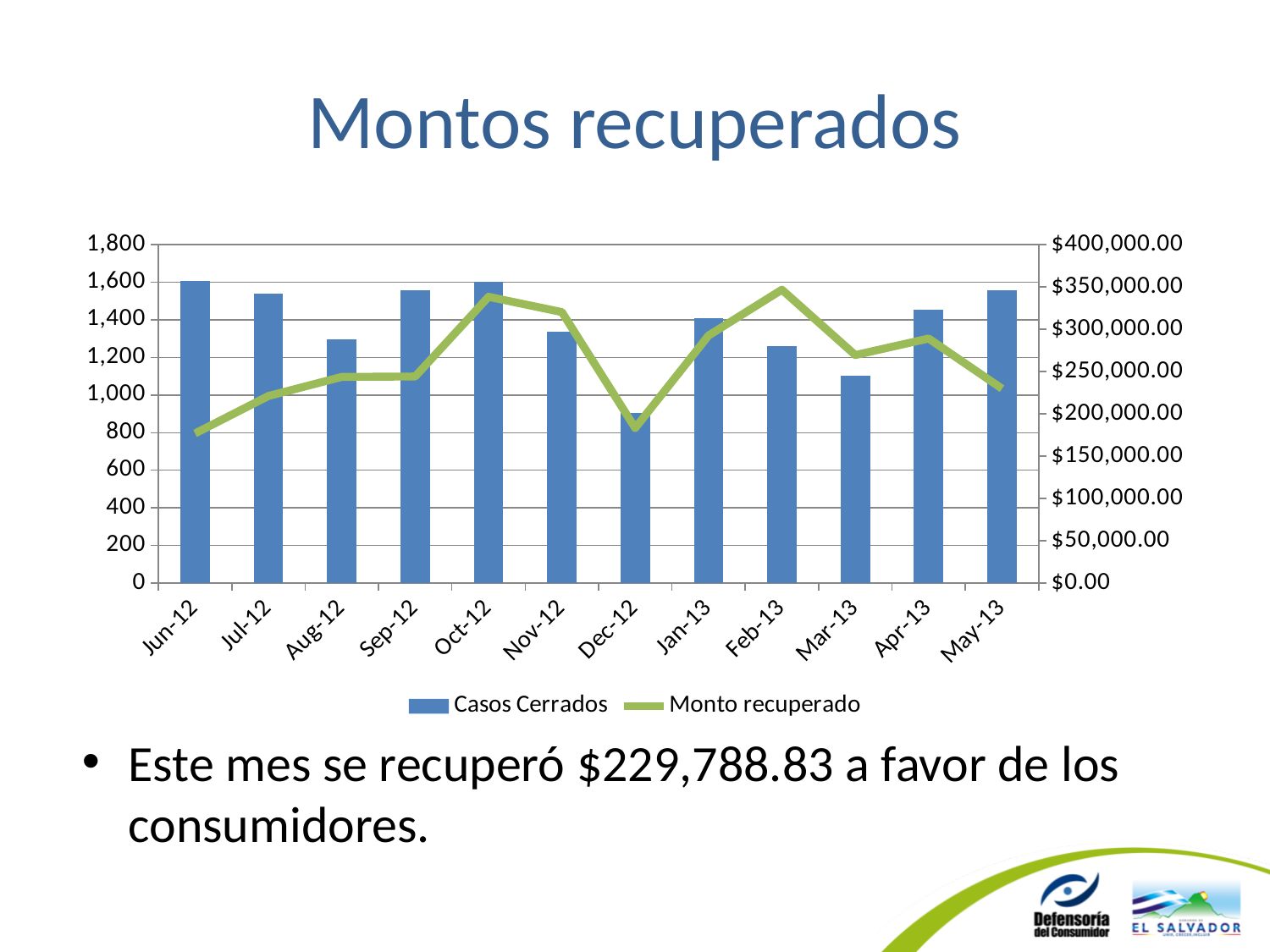
How many months are shown on the x axis of the chart? 12 Is the Monto recuperado value for Jun-12 greater or less than $200,000.00? less Which series is drawn as a line in the chart? Monto recuperado Is the Monto recuperado value for May-13 greater or less than $250,000.00? less How many series does the chart legend list? 2 Which month has more Casos Cerrados, Aug-12 or Sep-12? Sep-12 What kind of chart is shown on the slide? A combined bar and line chart Is the Casos Cerrados value for Dec-12 greater or less than 1,000? less Does the Monto recuperado line rise or fall from Sep-12 to Oct-12? rise Which month has the lowest bar for Casos Cerrados? Dec-12